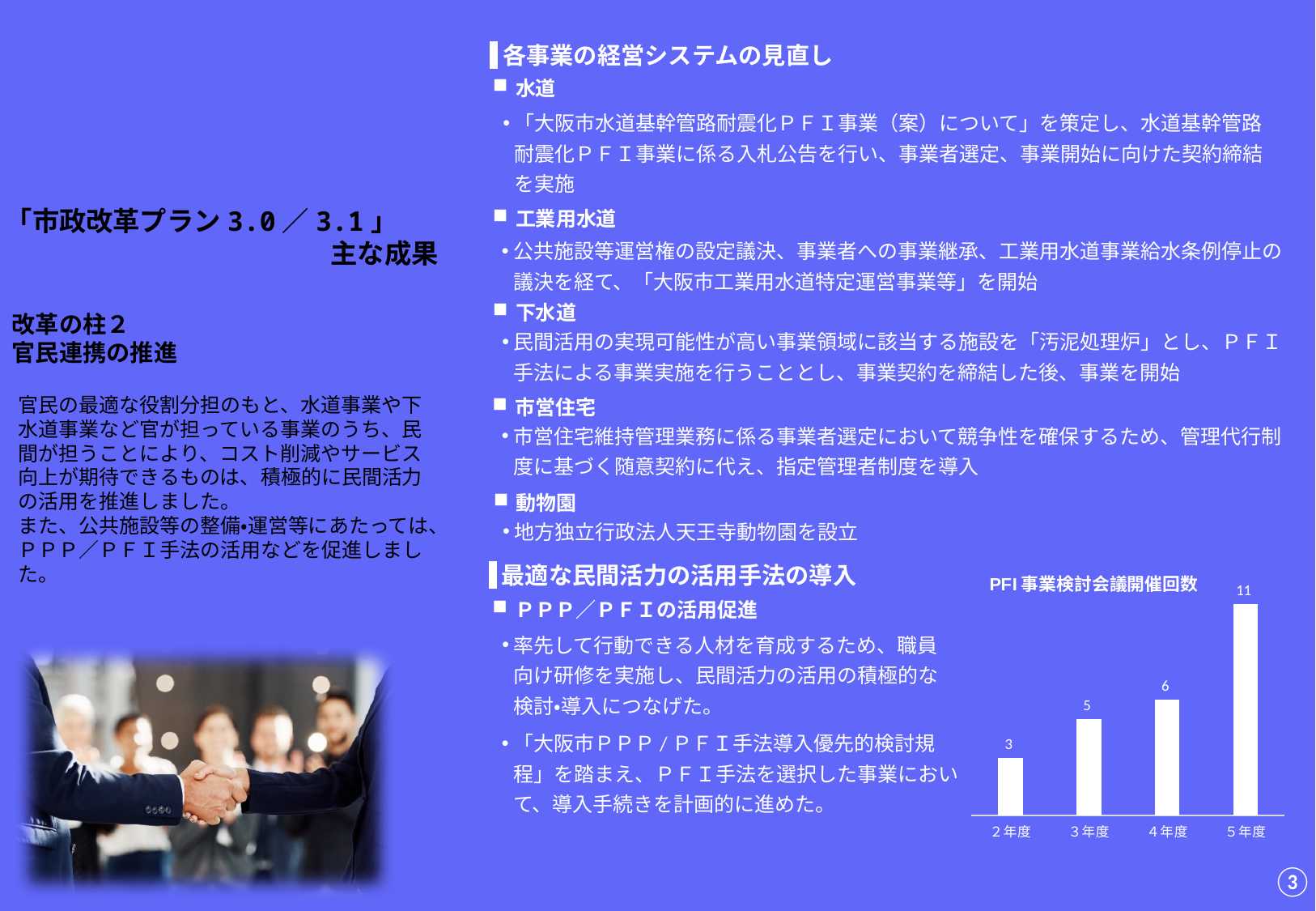
What is the value for 2年度 in the PFI事業検討会議開催回数 chart? 3 What is the value for 4年度 in the PFI事業検討会議開催回数 chart? 6 Which is larger in the PFI事業検討会議開催回数 chart, the value for 3年度 or 4年度? 4年度 Which year has the highest value in the PFI事業検討会議開催回数 chart? 5年度 Which year has the lowest value in the PFI事業検討会議開催回数 chart? 2年度 What is the difference between the values for 3年度 and 2年度 in the PFI事業検討会議開催回数 chart? 2 What is the value for 5年度 in the PFI事業検討会議開催回数 chart? 11 What kind of chart is the PFI事業検討会議開催回数 chart? bar chart What is the value for 3年度 in the PFI事業検討会議開催回数 chart? 5 What is the difference between the values for 5年度 and 4年度 in the PFI事業検討会議開催回数 chart? 5 Do the values in the PFI事業検討会議開催回数 chart rise or fall from 2年度 to 5年度? rise How many years (categories) are shown in the PFI事業検討会議開催回数 chart? 4